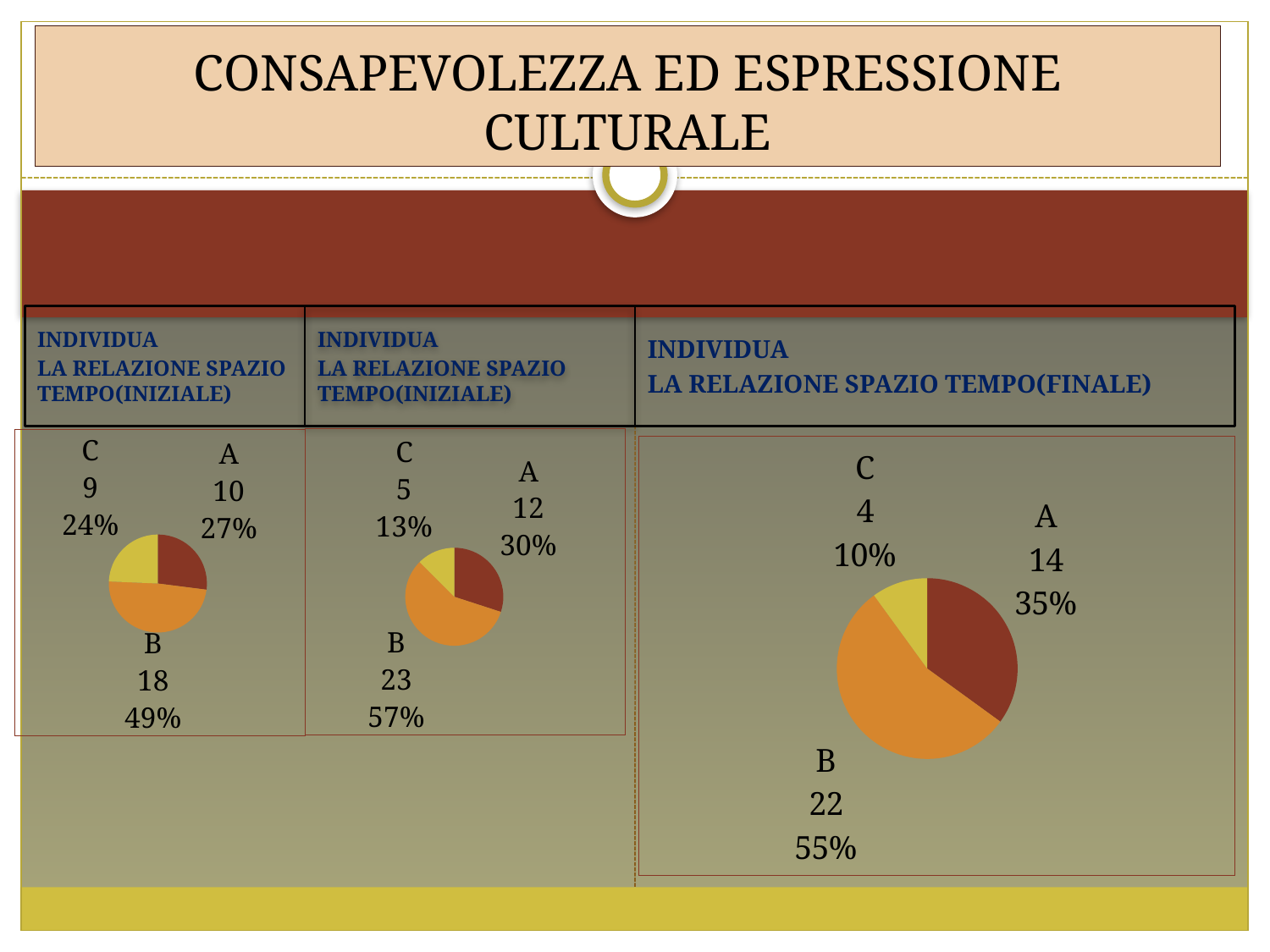
In the left pie chart, what value is shown for category B? 18 In the right pie chart (FINALE), what value is shown for category C? 4 In the middle pie chart, which category has the smallest slice? C In the right pie chart (FINALE), which is larger, the value for A or the value for C? A In the middle pie chart, what value is shown for category A? 12 In the middle pie chart, what percentage share does category B have? 57% In the right pie chart (FINALE), what percentage share does category A have? 35% In the right pie chart (FINALE), which category has the largest slice? B In the left pie chart, what percentage share does category C have? 24% In the left pie chart, what is the difference between the values for B and A? 8 What type of chart is used on this slide? Pie chart How many categories does the right pie chart (FINALE) show? 3